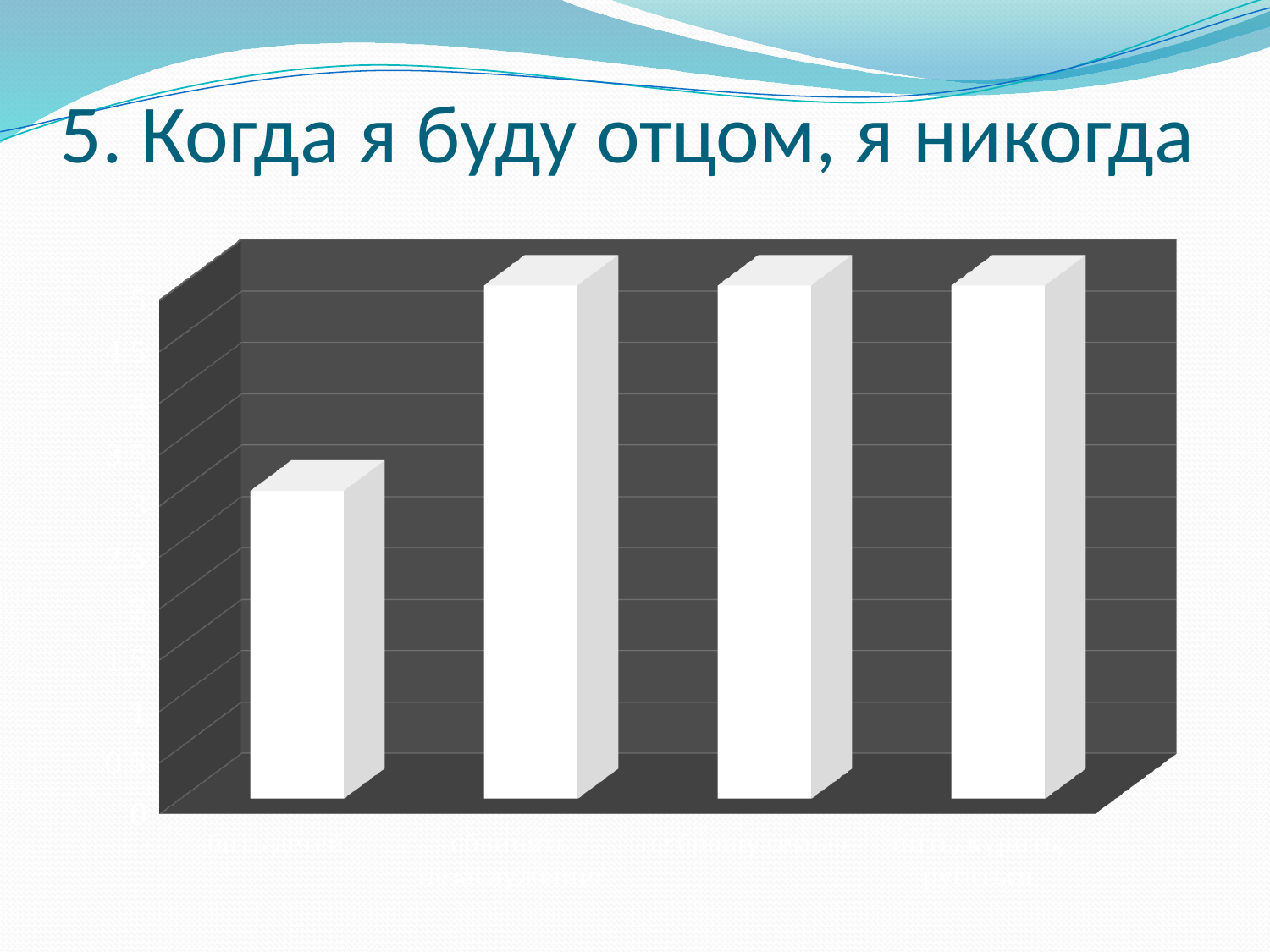
Is the value of the second bar from the left greater or less than 4? greater Is the value of the leftmost bar greater or less than 2? greater How many bars does the chart contain? 4 Is the value of the leftmost bar greater or less than 4? less Which is larger, the leftmost bar or the rightmost bar? the rightmost bar What kind of chart is shown on the slide? bar chart Which is larger, the first bar from the left or the second bar from the left? the second bar Do the bars rise or fall from the first bar to the second bar? rise What is the title shown above the chart? 5. Когда я буду отцом, я никогда What colour are the bars in the chart? white Which bar is the lowest in the chart? the first (leftmost) bar